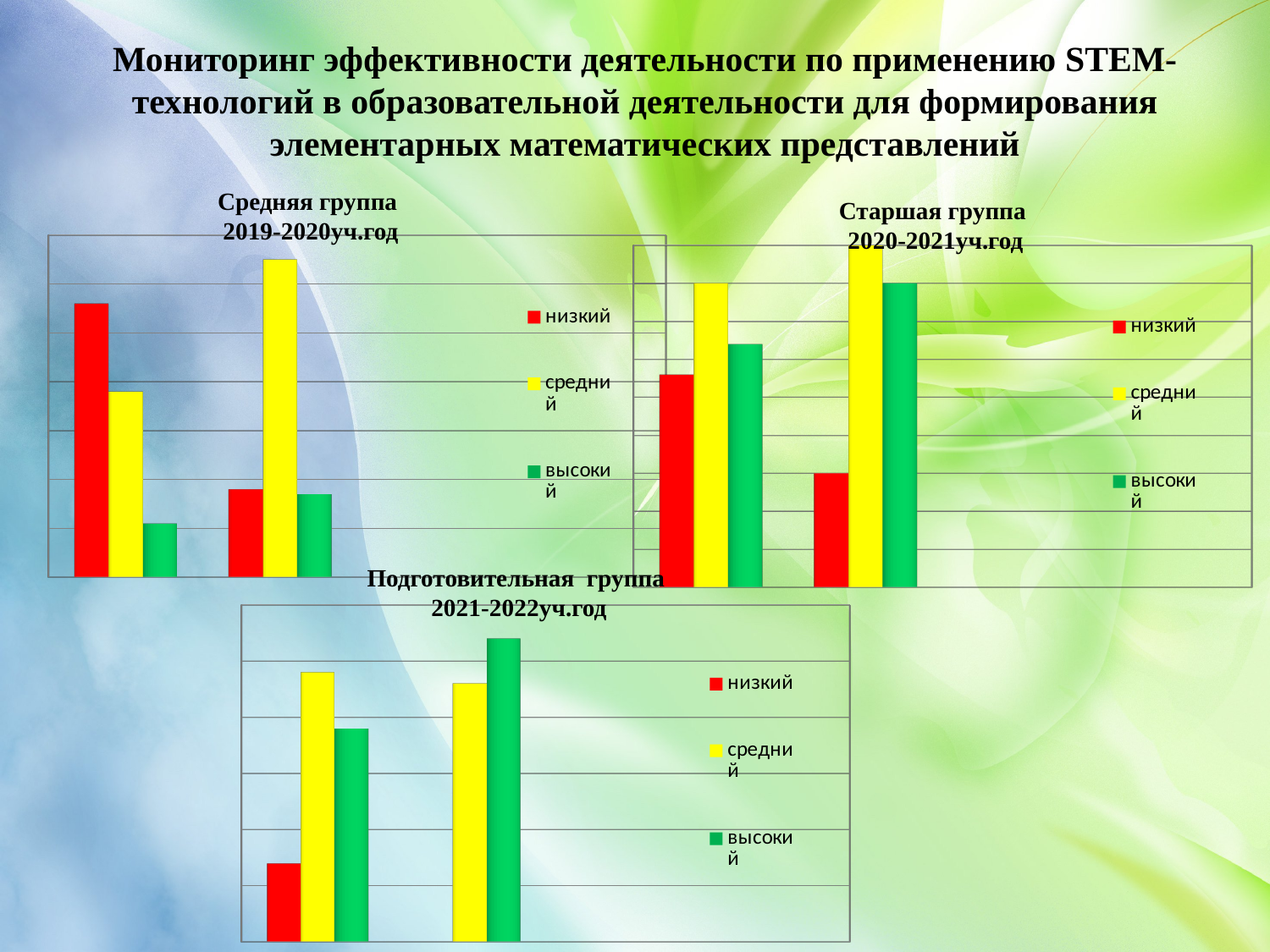
In the "Средняя группа 2019-2020уч.год" chart, which series has the tallest bar in the first (left) group? низкий In the "Подготовительная группа 2021-2022уч.год" chart, in the first (left) group, which is larger: средний or высокий? средний What are the legend entries of the "Подготовительная группа 2021-2022уч.год" chart? низкий, средний, высокий How many groups of bars are plotted in the "Старшая группа 2020-2021уч.год" chart? 2 In the "Средняя группа 2019-2020уч.год" chart, which series is shown in red? низкий In the "Средняя группа 2019-2020уч.год" chart, which series has the lowest bar in the first (left) group? высокий How many series does the legend of the "Старшая группа 2020-2021уч.год" chart list? 3 In the "Старшая группа 2020-2021уч.год" chart, in the first (left) group, which is larger: средний or низкий? средний How many charts are shown on the slide? 3 In the "Старшая группа 2020-2021уч.год" chart, which series has the lowest bar in the second (right) group? низкий In the "Подготовительная группа 2021-2022уч.год" chart, which series has the tallest bar in the second (right) group? высокий What kind of chart is the "Средняя группа 2019-2020уч.год" chart? bar chart